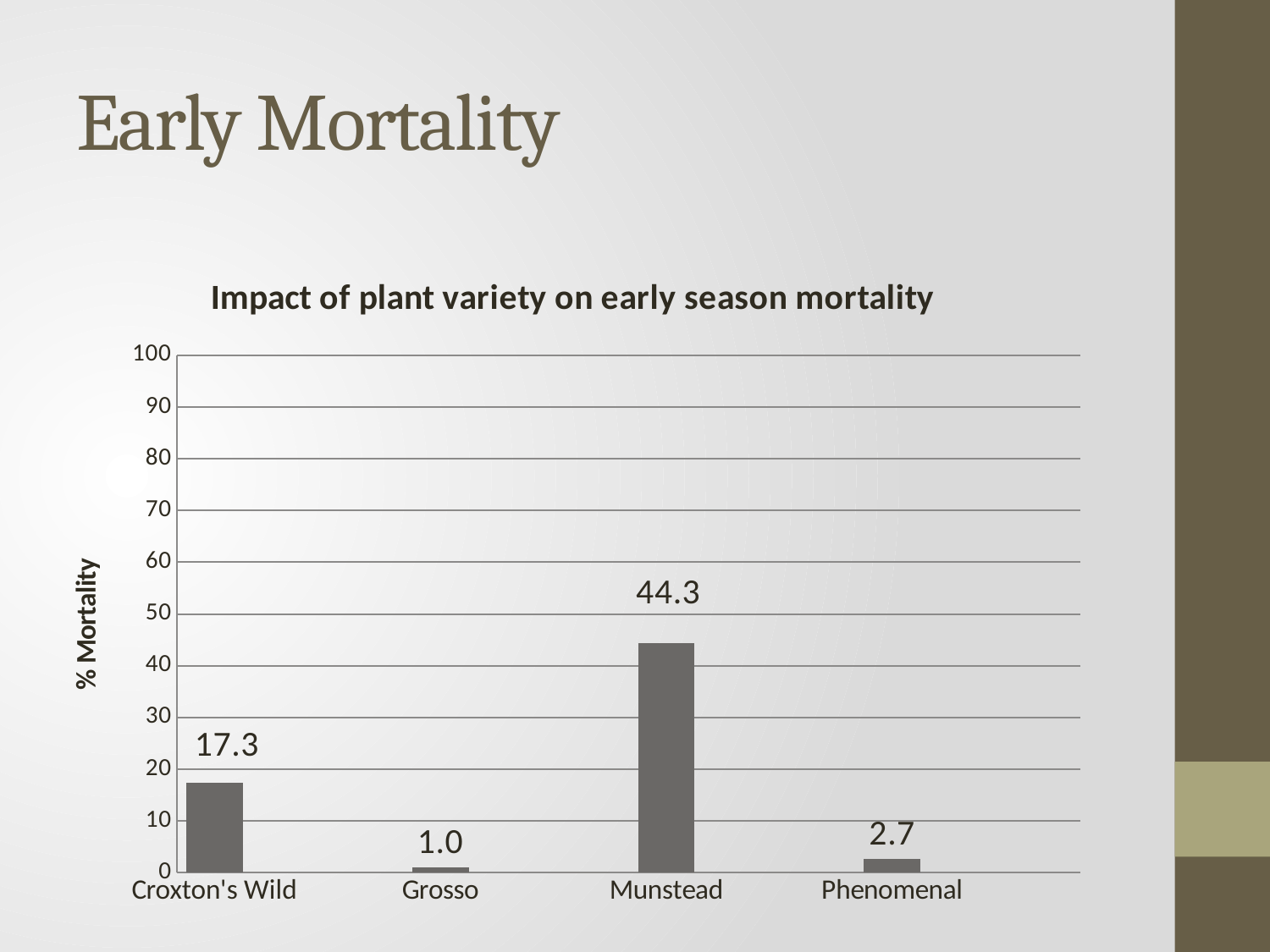
Which plant variety has the lowest early season mortality? Grosso How many plant varieties are shown on the x axis? 4 What kind of chart is shown on the slide? bar chart What is the difference in % Mortality between Munstead and Croxton's Wild? 27.0 Which has a higher % Mortality, Phenomenal or Grosso? Phenomenal What is the % Mortality value for Phenomenal? 2.7 What is the title of the chart? Impact of plant variety on early season mortality Is the value for Croxton's Wild greater or less than 20? less What is the % Mortality value for Croxton's Wild? 17.3 Which plant variety has the highest early season mortality? Munstead What is the % Mortality value for Munstead? 44.3 What is the % Mortality value for Grosso? 1.0